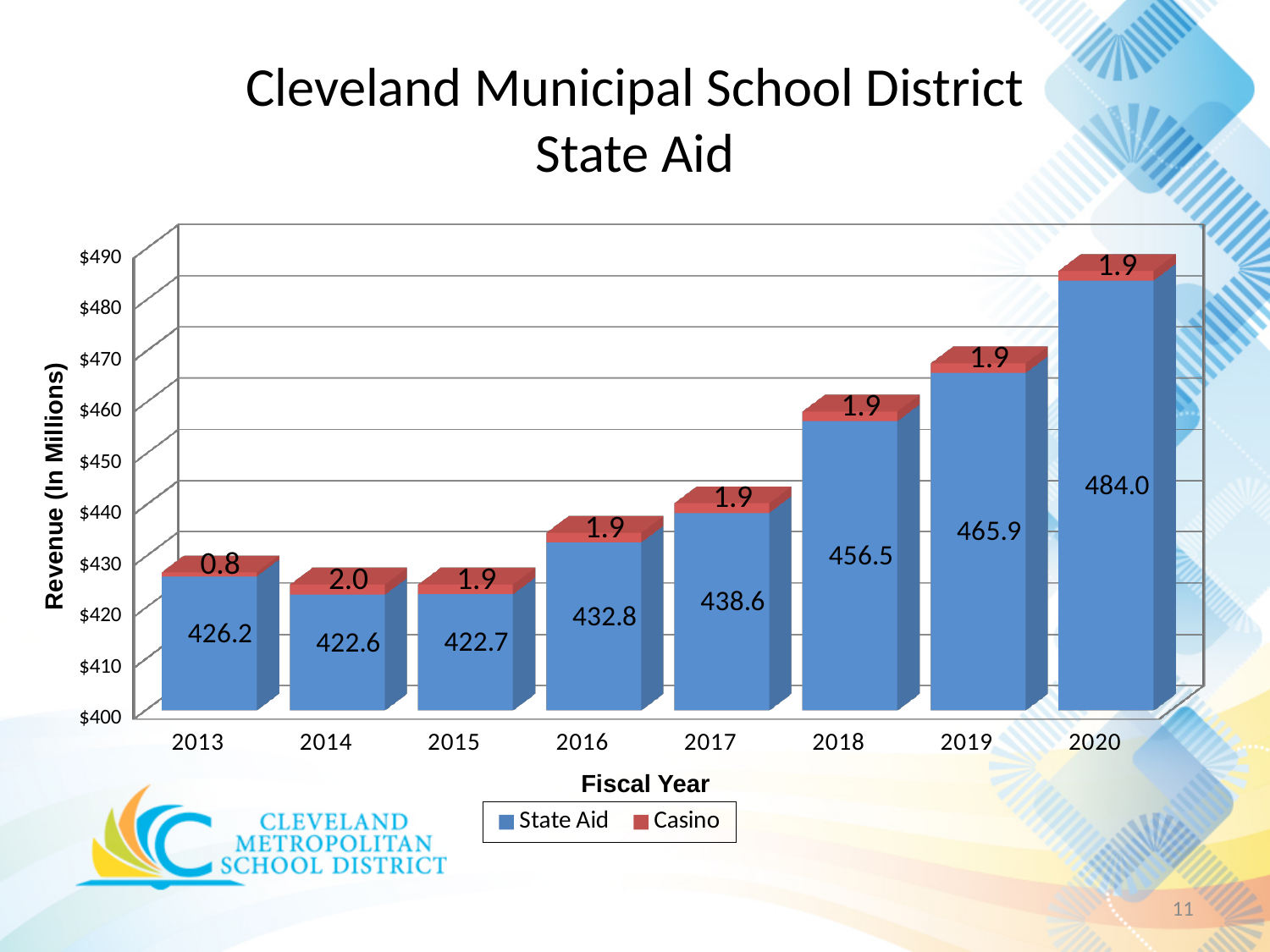
What is the Casino value for fiscal year 2013? 0.8 What is the total of the stacked bar for fiscal year 2020? 485.9 Which fiscal year has the highest State Aid value? 2020 Which fiscal year has the lowest State Aid value? 2014 How many series does the legend list? 2 What is the label of the y axis? Revenue (In Millions) How many fiscal years are shown on the x axis? 8 What is the difference between the State Aid values for 2020 and 2019? 18.1 What kind of chart is shown on the slide? Stacked bar chart What is the Casino value for fiscal year 2014? 2.0 What is the State Aid value for fiscal year 2018? 456.5 Which is larger, the State Aid value for 2016 or for 2017? 2017